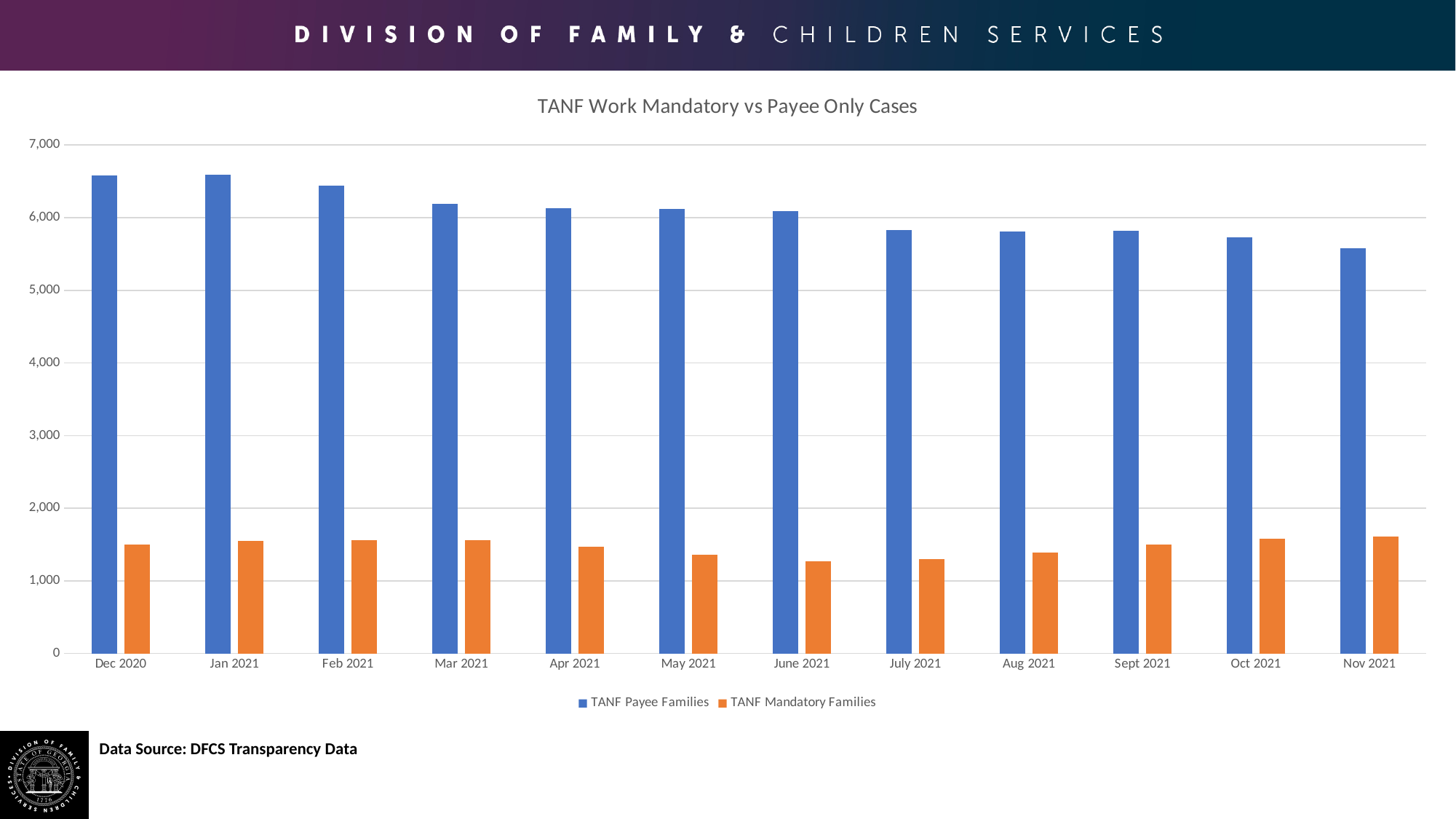
Which is larger, TANF Mandatory Families in Feb 2021 or in June 2021? Feb 2021 Which month has the lowest value for TANF Payee Families? Nov 2021 What is the title of the chart? TANF Work Mandatory vs Payee Only Cases How many series does the legend list? 2 Is the value for TANF Payee Families in Dec 2020 greater or less than 6,000? greater Is the value for TANF Mandatory Families in June 2021 greater or less than 1,000? greater Do the values for TANF Payee Families generally rise or fall from Dec 2020 to Nov 2021? fall What kind of chart is shown on the slide? bar chart Is the value for TANF Mandatory Families in Nov 2021 greater or less than 2,000? less Which is larger, TANF Payee Families in Dec 2020 or in Nov 2021? Dec 2020 How many months are shown on the x axis? 12